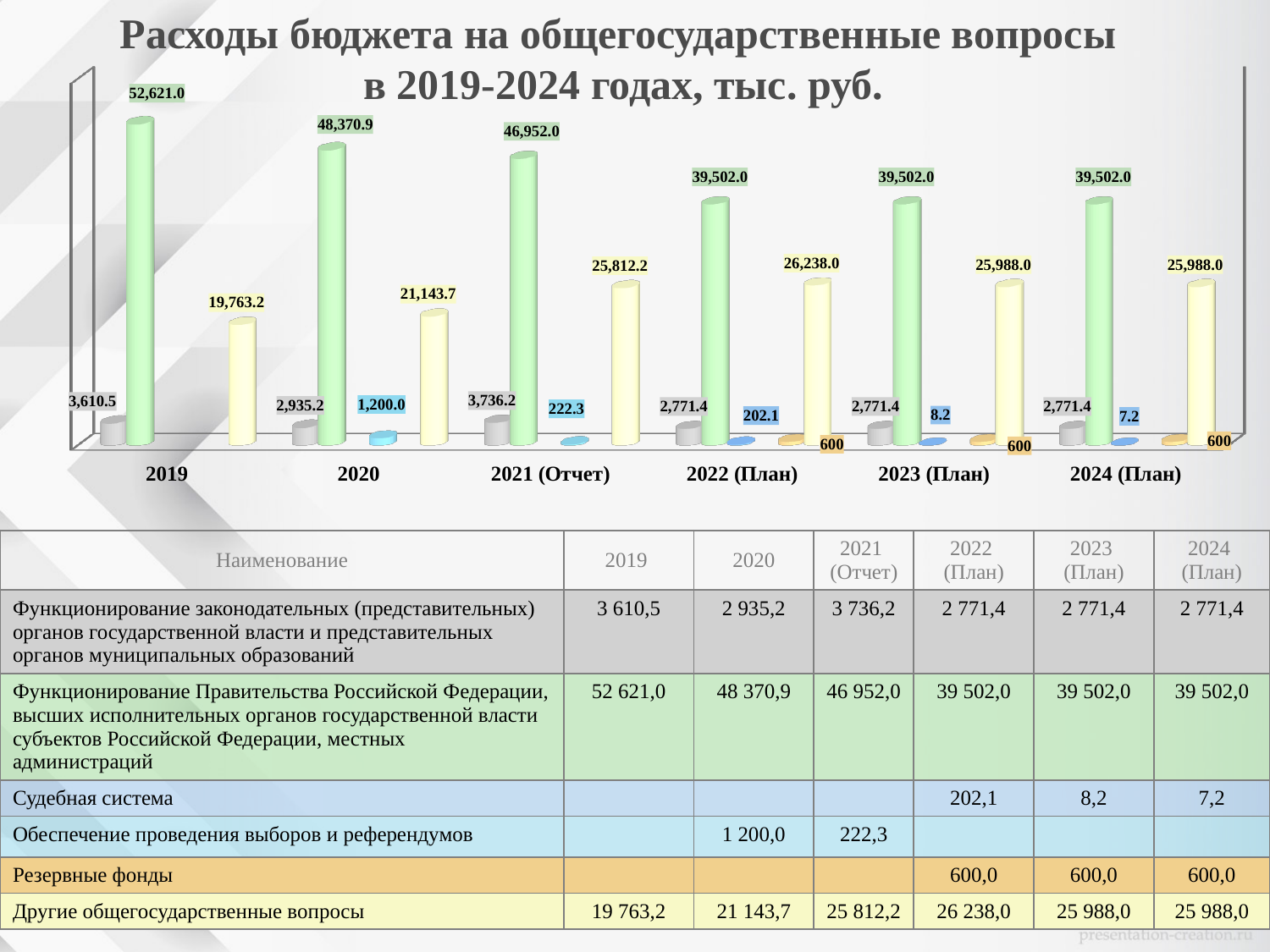
In which year is the green bar (Функционирование Правительства Российской Федерации...) highest? 2019 What is the value of the orange bar (Резервные фонды) for 2024 (План)? 600 By how much does the green bar for 2019 exceed the green bar for 2020? 4,250.1 What is the value of the yellow bar (Другие общегосударственные вопросы) for 2022 (План)? 26,238.0 In which year is the grey bar (Функционирование законодательных органов...) highest? 2021 (Отчет) Do the green bars rise or fall from 2019 to 2022 (План)? Fall What is the value labelled for Судебная система in 2022 (План)? 202.1 What is the difference between the yellow bar for 2020 and the yellow bar for 2019? 1,380.5 What kind of chart is shown on the slide? Bar chart Which is larger: the yellow bar for 2021 (Отчет) or for 2022 (План)? 2022 (План) How many year categories are shown on the x axis of the chart? 6 What is the value of the green bar (Функционирование Правительства Российской Федерации...) for 2019? 52,621.0